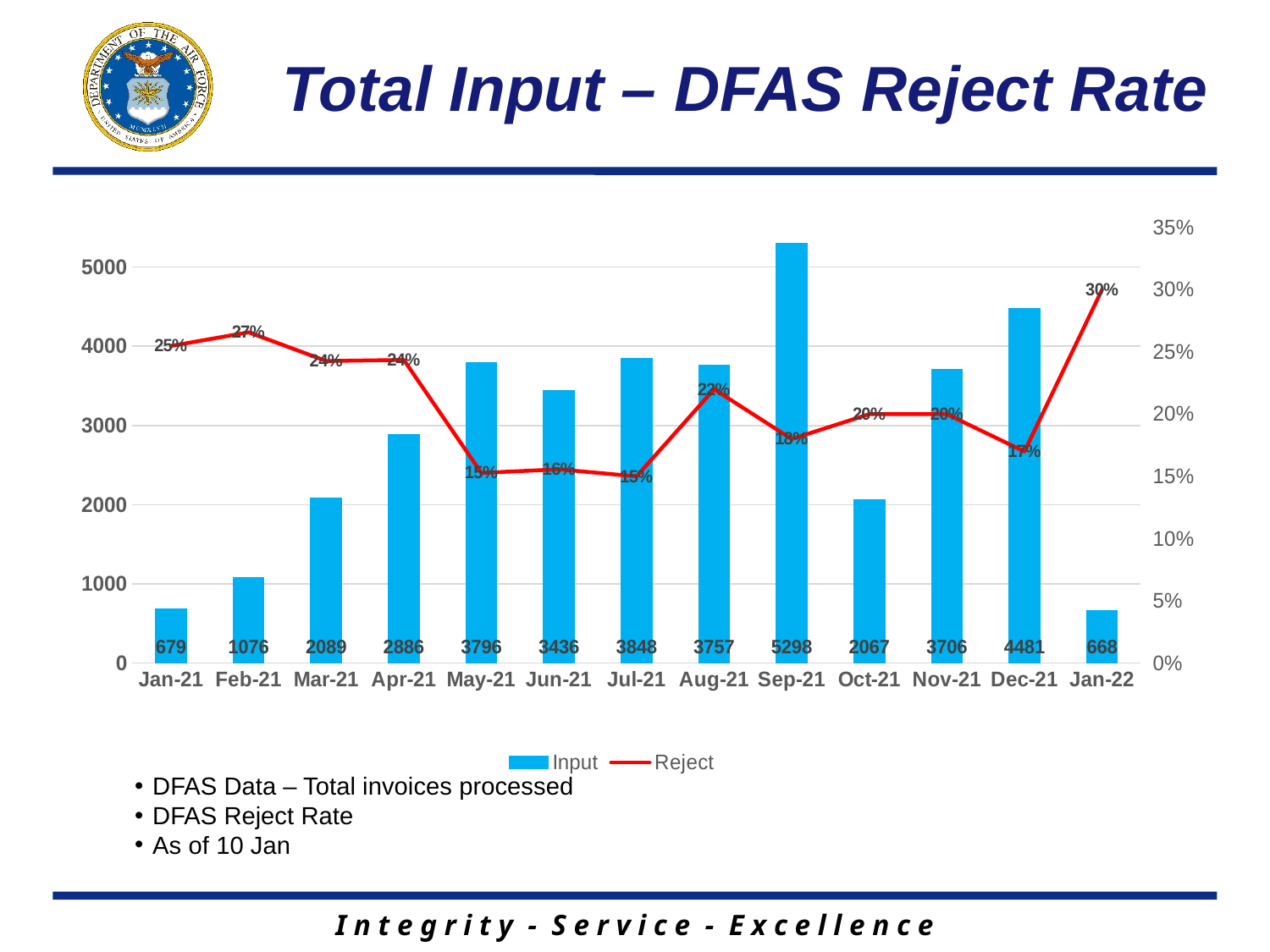
How many series does the legend list? 2 What is the Reject rate for Jan-22? 30% What is the Input value for Sep-21? 5298 How many months are shown on the x axis? 13 Which month has the lowest Input value? Jan-22 Which has the larger Input value, May-21 or Jul-21? Jul-21 What is the difference between the Input values for Sep-21 and Dec-21? 817 Which month has the highest Input value? Sep-21 What is the title of the chart on the slide? Total Input – DFAS Reject Rate What kind of chart is shown on the slide? A bar chart combined with a line chart What is the Reject rate for Feb-21? 27% Does the Reject rate rise or fall from Jan-21 to May-21? Fall